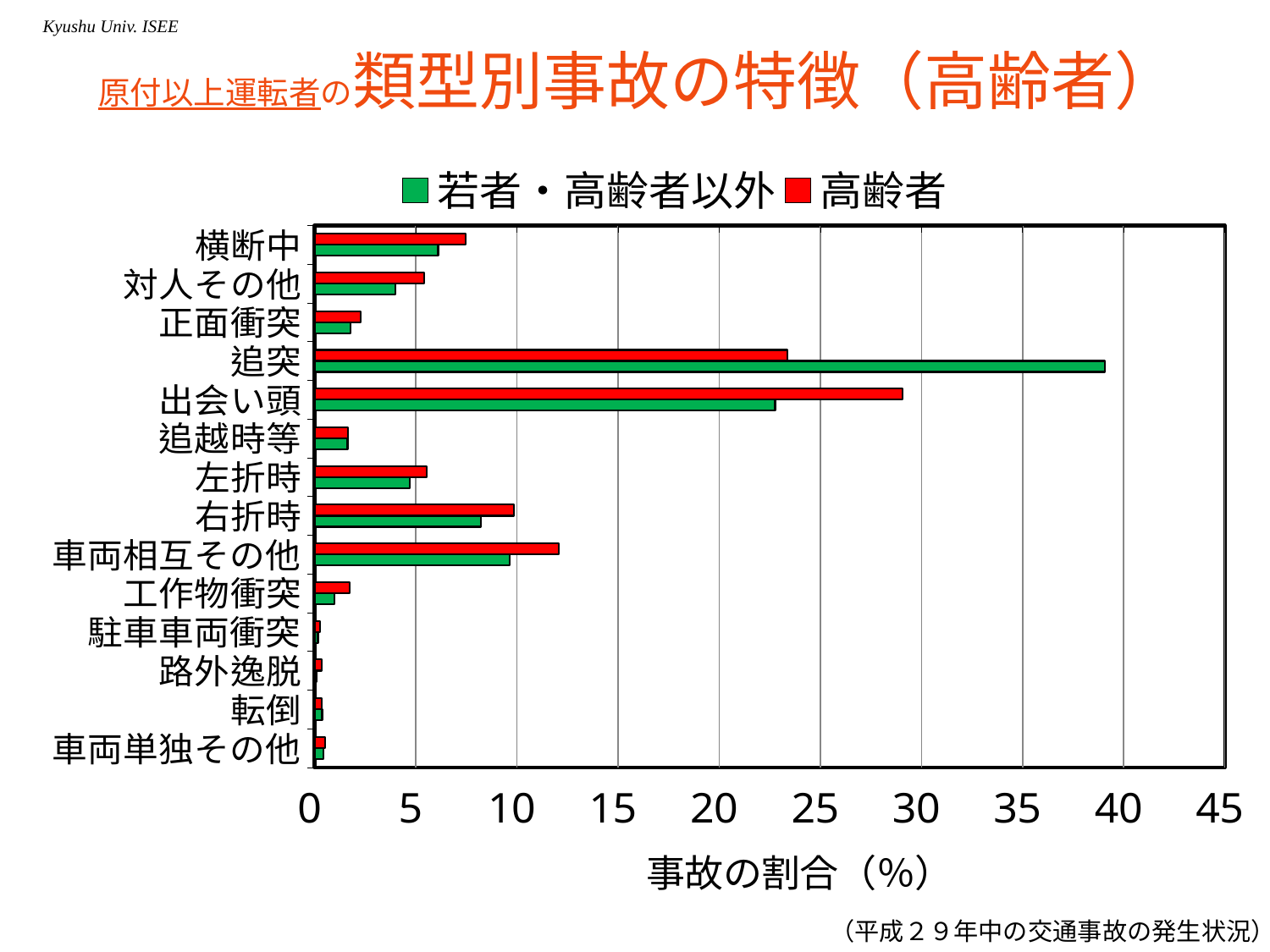
How many series does the legend list? 2 Is the 若者・高齢者以外 value for 追突 greater or less than 35? greater Which category has the highest value for the 若者・高齢者以外 series? 追突 Is the 高齢者 value for 車両相互その他 greater or less than 10? greater Which category has the highest value for the 高齢者 series? 出会い頭 Is the 高齢者 value for 追突 greater or less than 25? less What kind of chart is shown on the slide? bar chart What is the title of the x axis? 事故の割合（%） For 出会い頭, which series has the larger value, 若者・高齢者以外 or 高齢者? 高齢者 For 追突, which series has the larger value, 若者・高齢者以外 or 高齢者? 若者・高齢者以外 How many accident categories are plotted on the y axis? 14